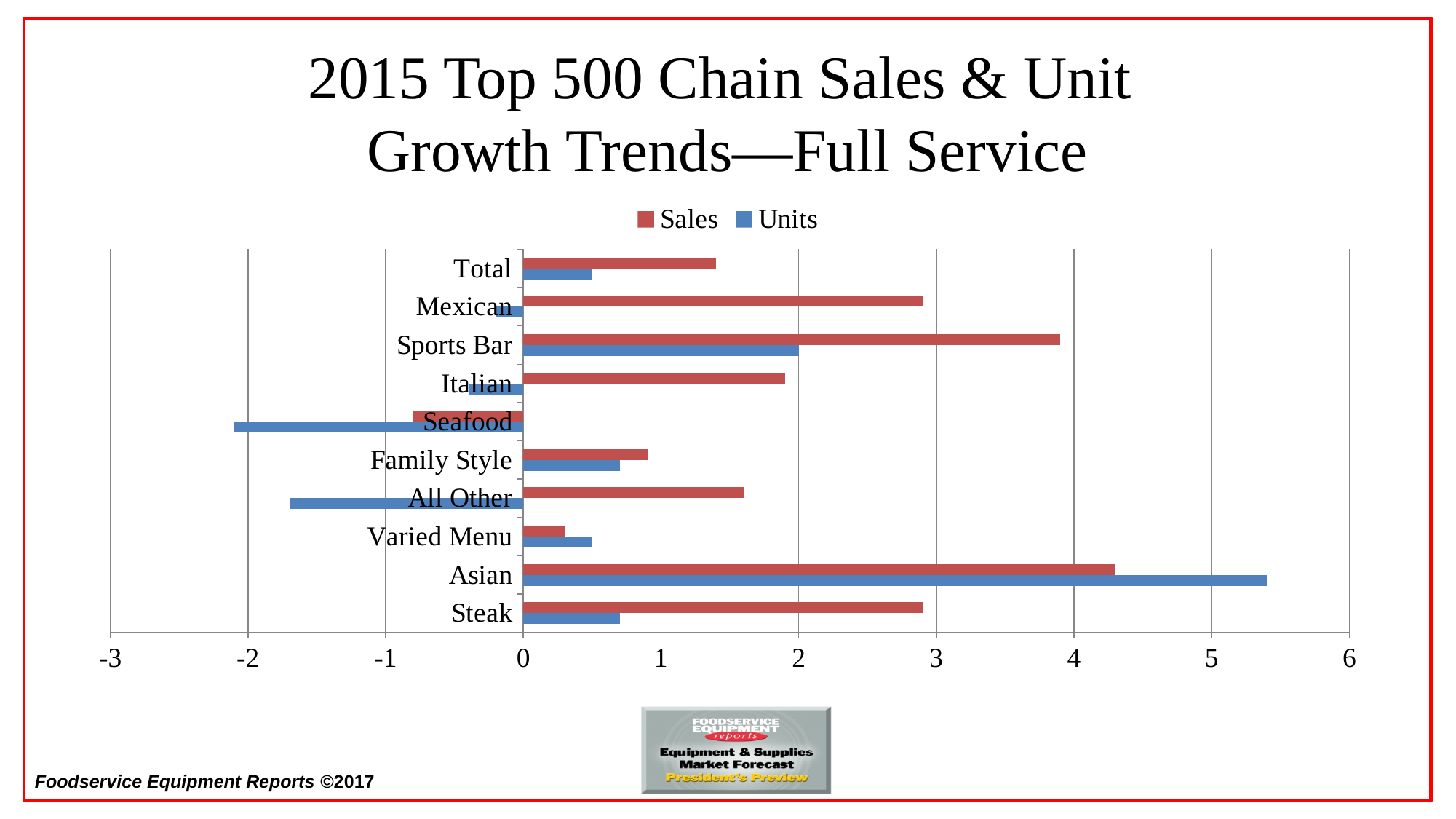
What is the Units value for Sports Bar? 2 Which category has the lowest Sales value? Seafood Which category has the highest Sales value? Asian Which category has the highest Units value? Asian What kind of chart is shown on the slide? Bar chart For Asian, which is larger, the Sales value or the Units value? Units Is the Sales value for Sports Bar greater or less than 3? greater Is the Units value for Asian greater or less than 5? greater How many series does the legend list? 2 Which category has the lowest Units value? Seafood Is the Units value for All Other greater or less than -1? less How many categories are plotted on the chart? 10